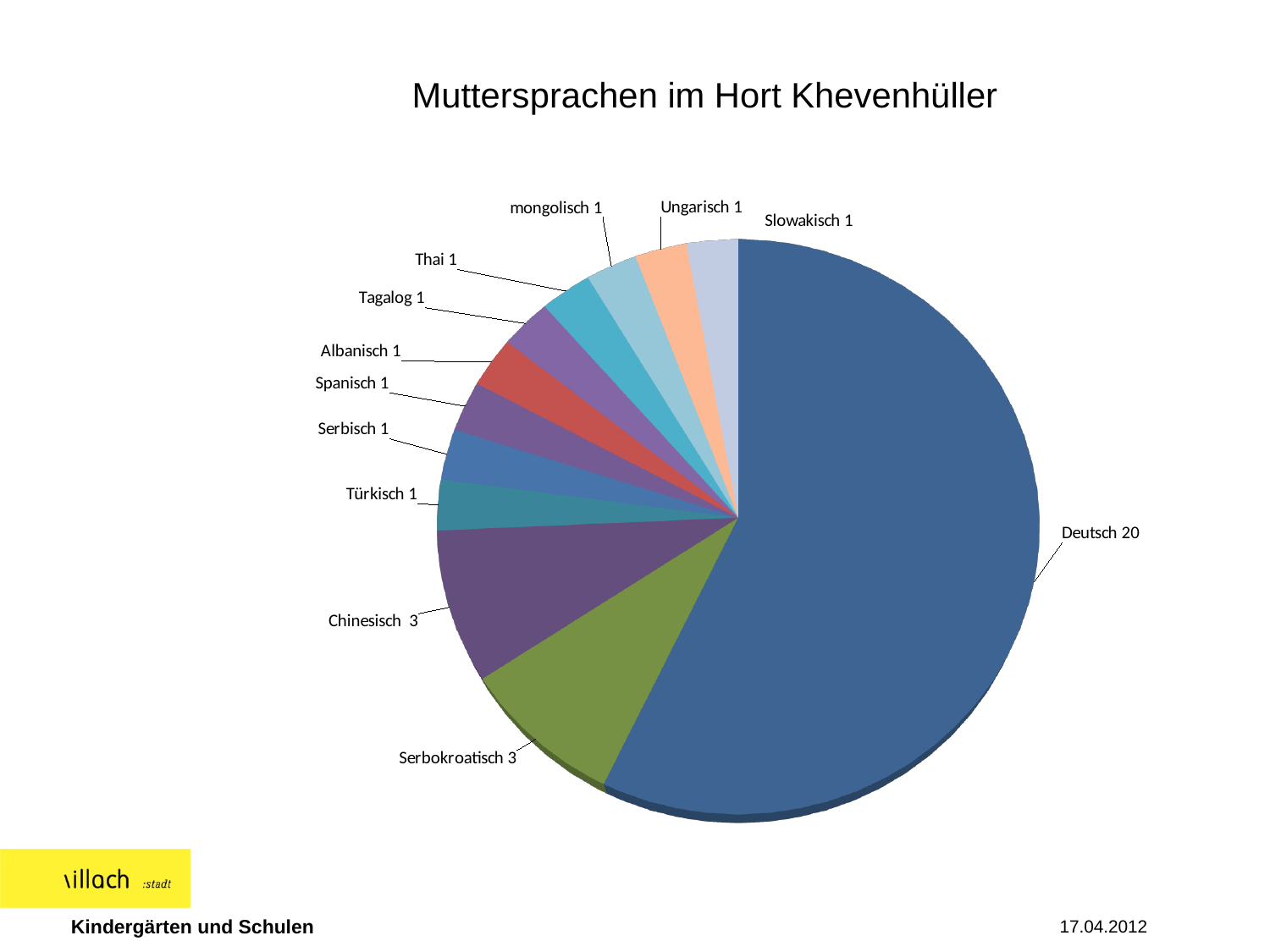
What is the value for Deutsch? 20 What share of the total does Deutsch represent, as a percentage rounded to the nearest whole number? 57% What is the value for Türkisch? 1 How many slices (languages) does the pie chart have? 12 Which is larger, the value for Chinesisch or the value for Thai? Chinesisch Which language has the largest slice of the pie? Deutsch What is the value for Serbokroatisch? 3 What type of chart is shown on the slide? pie chart What is the value for Chinesisch? 3 What is the total of all values shown in the pie chart? 35 What is the difference between the values for Deutsch and Serbokroatisch? 17 What is the title of the chart? Muttersprachen im Hort Khevenhüller